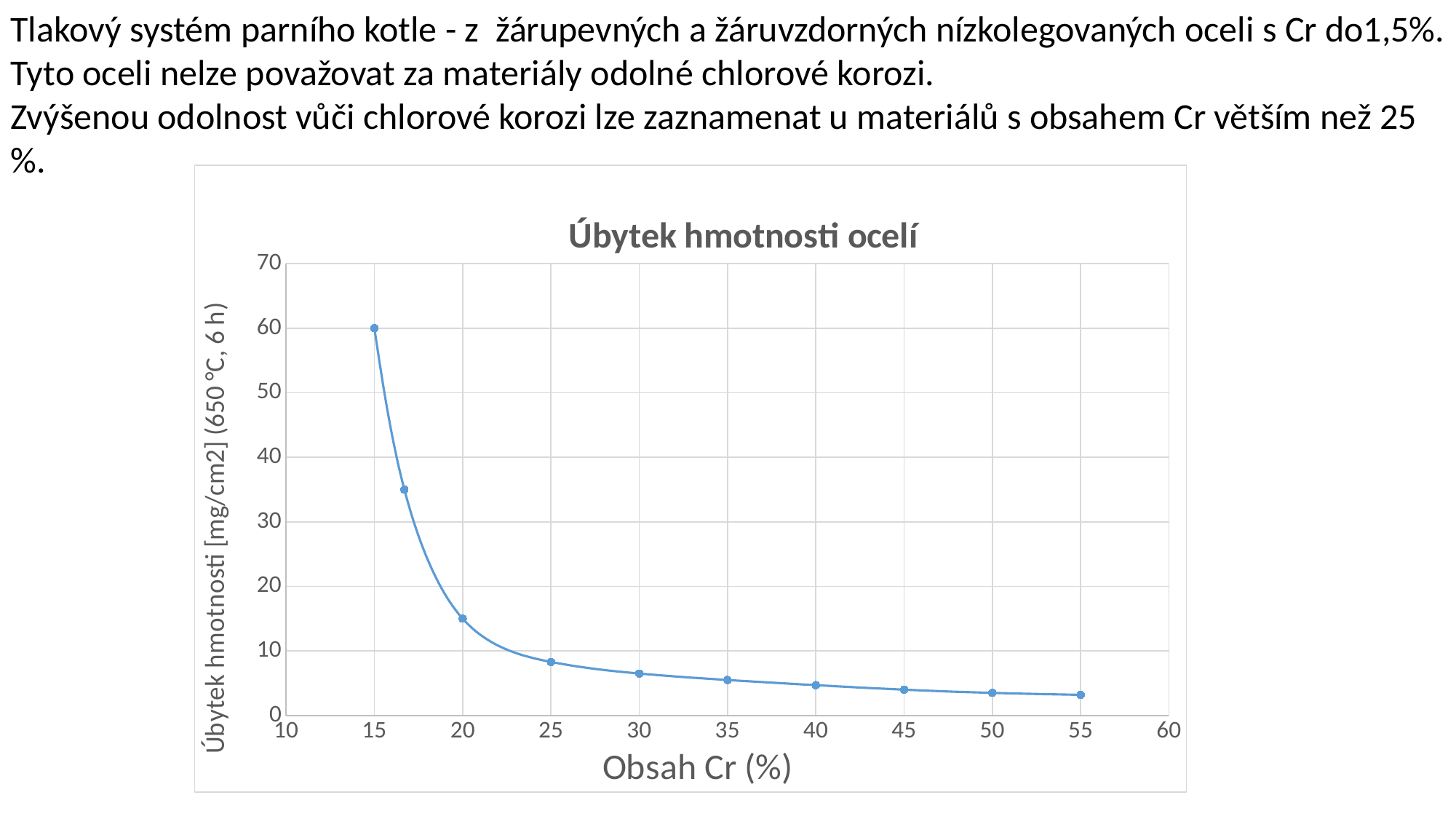
What is the label of the x axis of the chart? Obsah Cr (%) Does the mass loss rise or fall as the Cr content increases along the x axis? fall Which has the larger mass loss, 20% Cr or 25% Cr? 20% Cr Is the mass loss at 20% Cr greater or less than 10? greater At which Cr content is the mass loss highest? 15 How many data points are plotted on the chart? 10 What is the title of the chart? Úbytek hmotnosti ocelí Is the mass loss at 30% Cr greater or less than 10? less Is the mass loss at 25% Cr greater or less than 10? less What is the mass loss at 15% Cr? 60 What kind of chart is shown on the slide? line chart